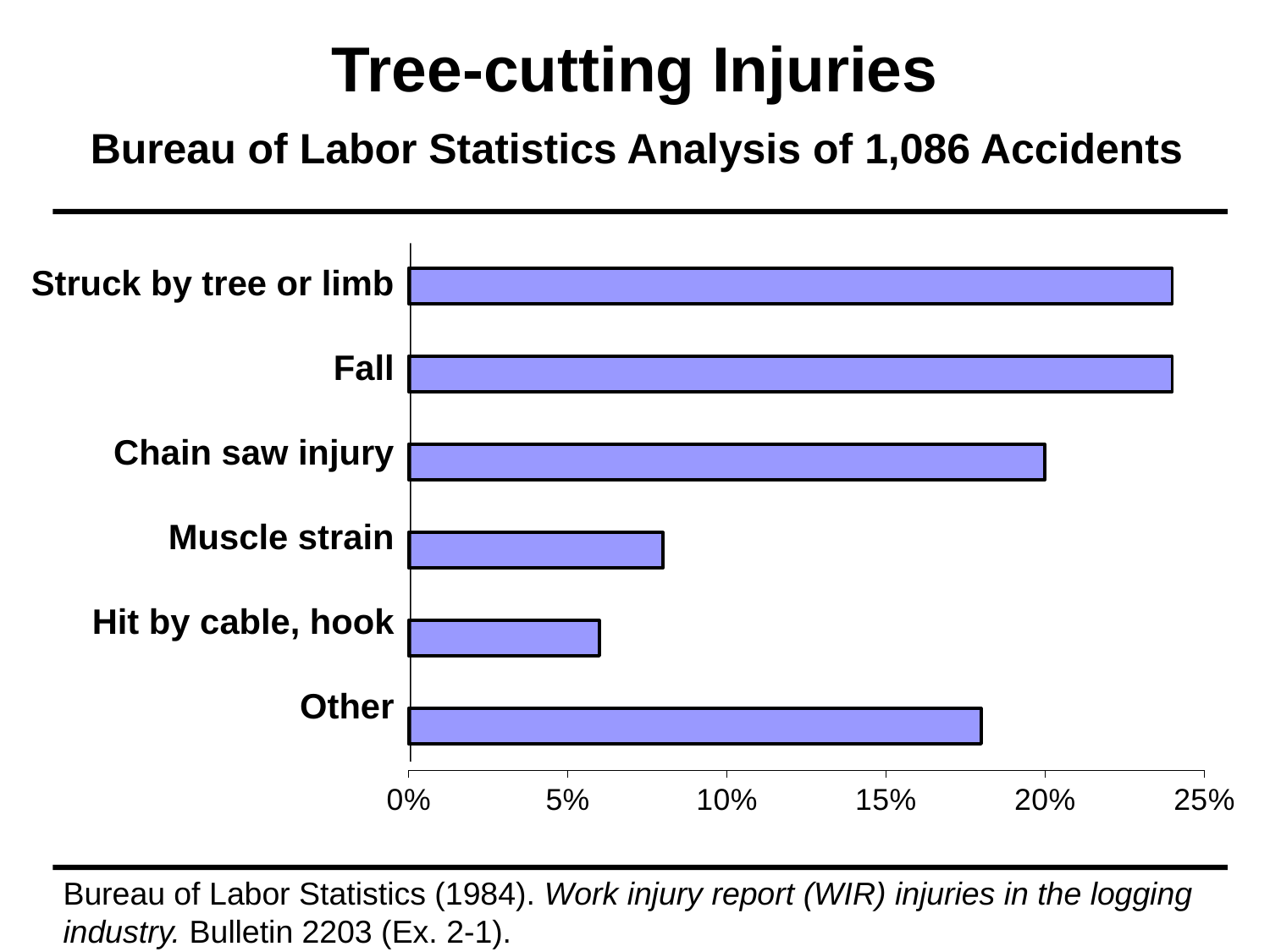
Which category has the lowest value? Hit by cable, hook Is the value for Other greater or less than 20%? less Which is larger, the value for Chain saw injury or the value for Other? Chain saw injury Is the value for Muscle strain greater or less than 10%? less What kind of chart is shown on the slide? bar chart Which is larger, the value for Muscle strain or the value for Hit by cable, hook? Muscle strain Is the value for Hit by cable, hook greater or less than 5%? greater How many accidents does the subtitle say the Bureau of Labor Statistics analysis covers? 1,086 What is the value for Chain saw injury? 20% What is the title of the chart on the slide? Tree-cutting Injuries How many injury categories are plotted in the chart? 6